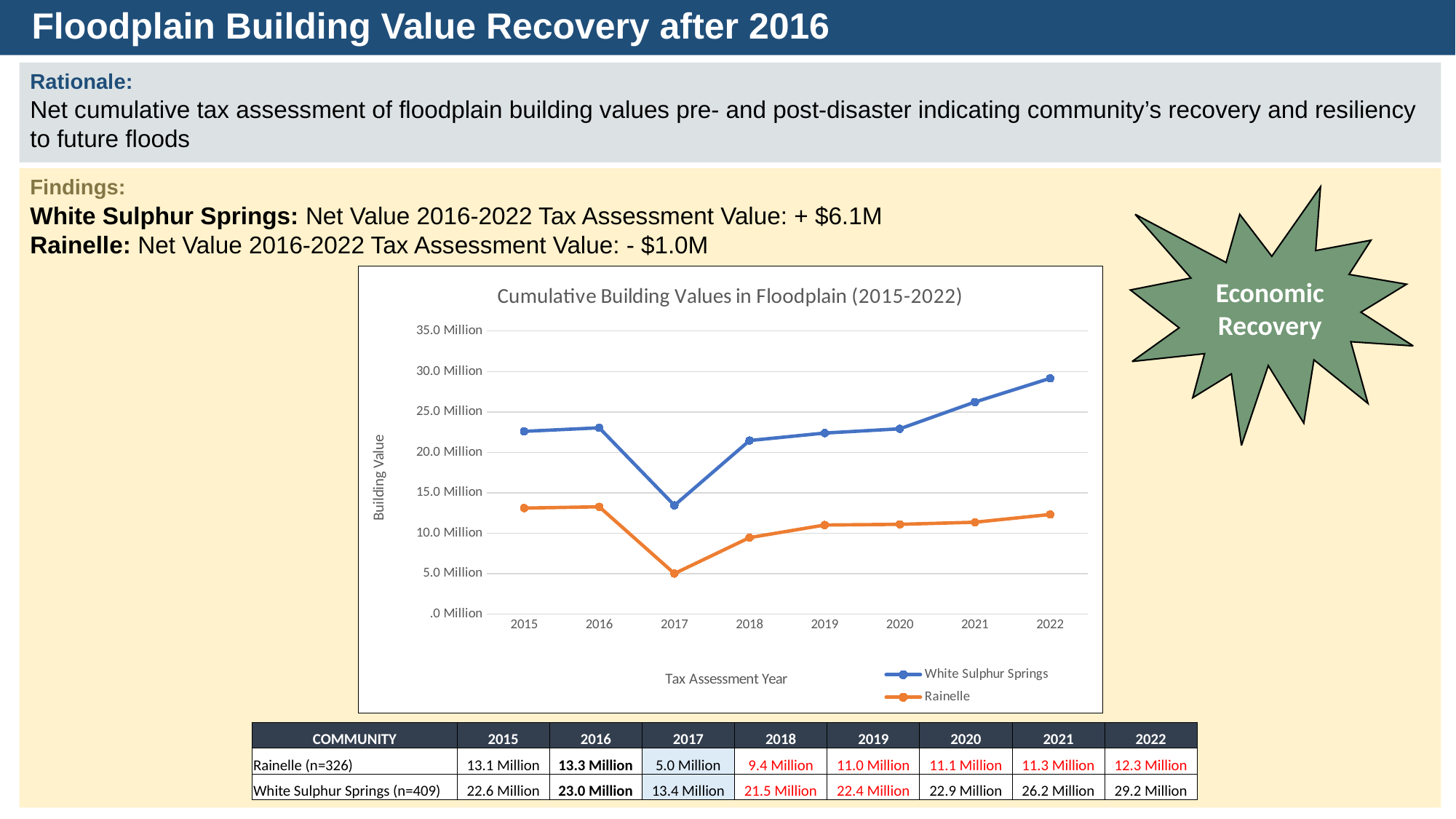
How many years are plotted along the x axis of the chart? 8 In which year is the Rainelle building value highest? 2016 What type of chart is shown on the slide? line chart What is the title of the chart? Cumulative Building Values in Floodplain (2015-2022) How many series does the chart legend list? 2 What is the building value for Rainelle in 2022? 12.3 Million What is the difference between the White Sulphur Springs and Rainelle building values in 2022? 16.9 Million Does the Rainelle building value rise or fall from 2017 to 2022? rise Which series has the higher building value in 2019, White Sulphur Springs or Rainelle? White Sulphur Springs Is the White Sulphur Springs building value in 2022 greater or less than 25.0 Million? greater What is the building value for White Sulphur Springs in 2017? 13.4 Million In which year is the White Sulphur Springs building value lowest? 2017